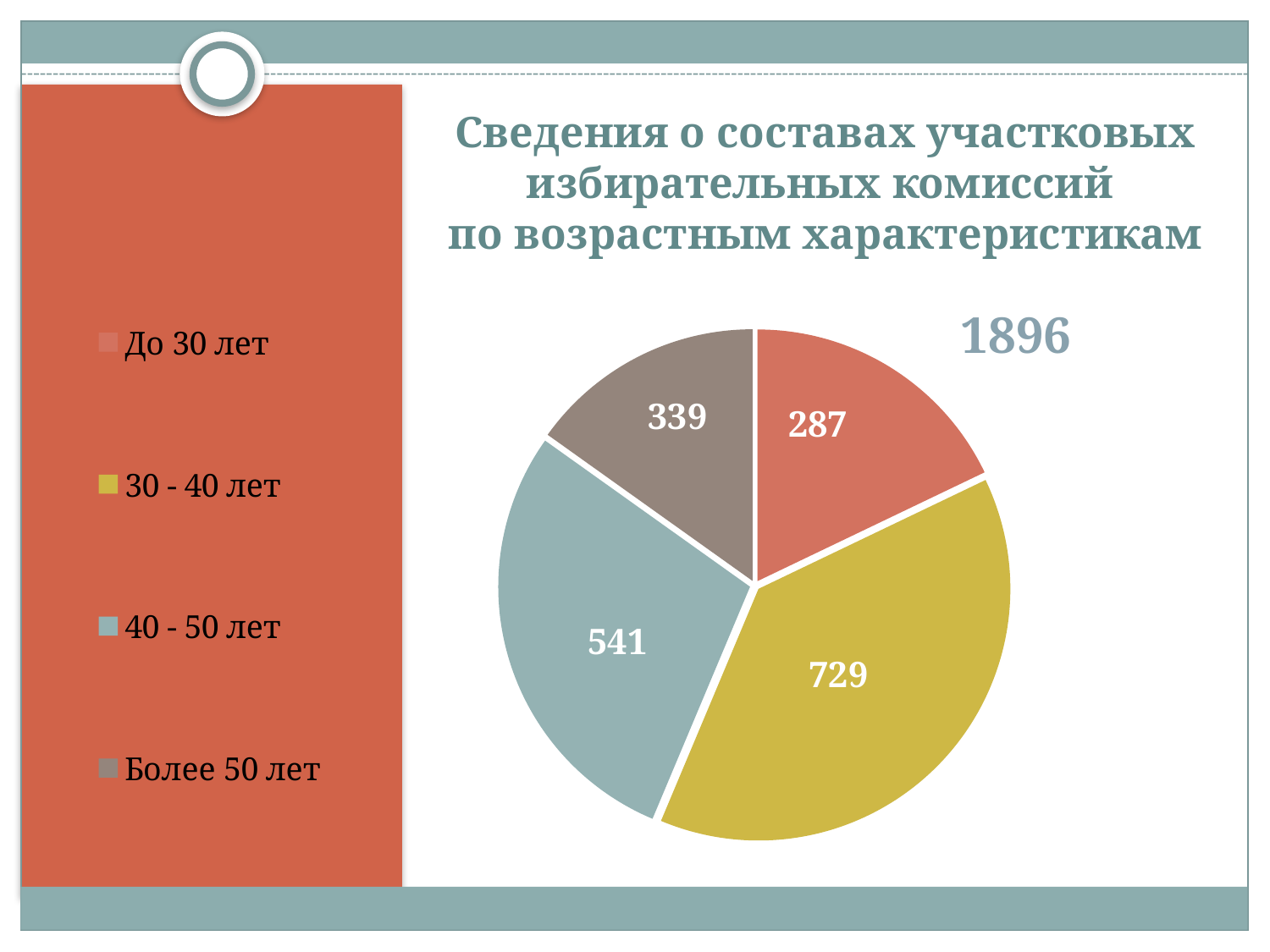
What is the difference between the "30 - 40 лет" and "40 - 50 лет" values? 188 What colour is the "30 - 40 лет" slice? yellow What kind of chart is shown on the slide? pie chart What is the value for the "40 - 50 лет" slice? 541 What is the value for the "До 30 лет" slice? 287 What is the total of all slices in the pie chart? 1896 Which age group has the smallest slice? До 30 лет Which is larger, the value for "40 - 50 лет" or for "Более 50 лет"? 40 - 50 лет How many slices does the pie chart have? 4 What is the value for the "30 - 40 лет" slice? 729 Which age group has the largest slice? 30 - 40 лет What is the value for the "Более 50 лет" slice? 339